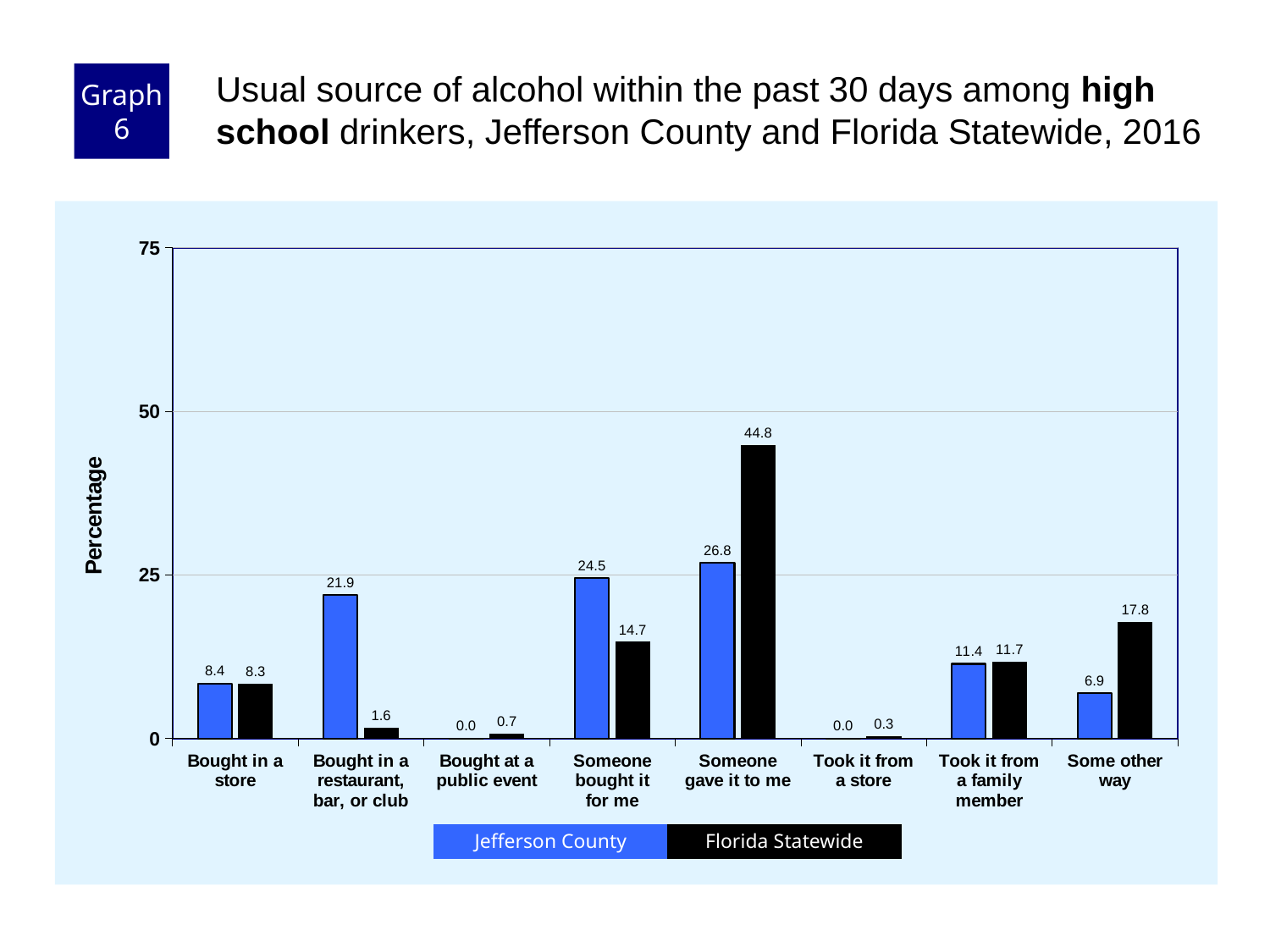
What is the difference between the Florida Statewide and Jefferson County values for "Someone gave it to me"? 18.0 What is the difference between the Jefferson County and Florida Statewide values for "Bought in a restaurant, bar, or club"? 20.3 Which category has the lowest Jefferson County value? Bought at a public event and Took it from a store (both 0.0) Which category has the highest Florida Statewide value? Someone gave it to me What is the Jefferson County value for "Someone gave it to me"? 26.8 How many source categories are shown on the x axis? 8 What is the Florida Statewide value for "Bought in a restaurant, bar, or club"? 1.6 What kind of chart is shown on the slide? Bar chart Is the Florida Statewide value for "Someone gave it to me" greater or less than 25? greater How many series does the legend list? 2 What is the label of the y axis? Percentage Which is larger for "Someone bought it for me": Jefferson County or Florida Statewide? Jefferson County